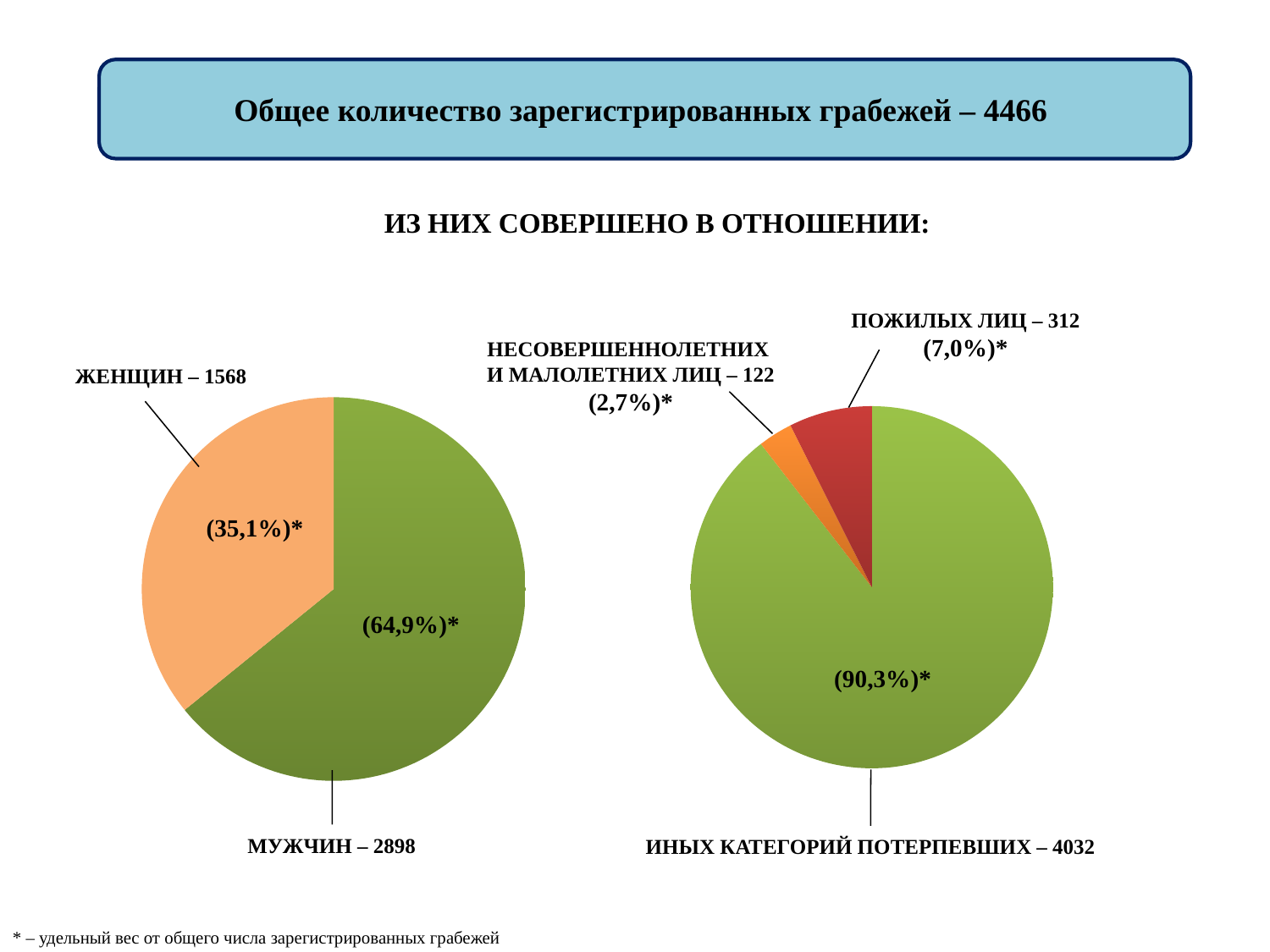
How many categories does the right pie chart show? 3 On the right pie chart, what is the value for НЕСОВЕРШЕННОЛЕТНИХ И МАЛОЛЕТНИХ ЛИЦ? 122 On the right pie chart, what share of the pie does the ИНЫХ КАТЕГОРИЙ ПОТЕРПЕВШИХ slice represent? 90,3% On the right pie chart, which category has the largest value? ИНЫХ КАТЕГОРИЙ ПОТЕРПЕВШИХ On the left pie chart, what is the difference between the values for МУЖЧИН and ЖЕНЩИН? 1330 On the left pie chart, what is the value for ЖЕНЩИН? 1568 What type of chart is shown on the left of the slide? Pie chart On the left pie chart, what is the value for МУЖЧИН? 2898 On the left pie chart, what share of the pie does the ЖЕНЩИН slice represent? 35,1% On the right pie chart, what is the value for ПОЖИЛЫХ ЛИЦ? 312 On the right pie chart, which category has the smallest value? НЕСОВЕРШЕННОЛЕТНИХ И МАЛОЛЕТНИХ ЛИЦ On the left pie chart, what share of the pie does the МУЖЧИН slice represent? 64,9%